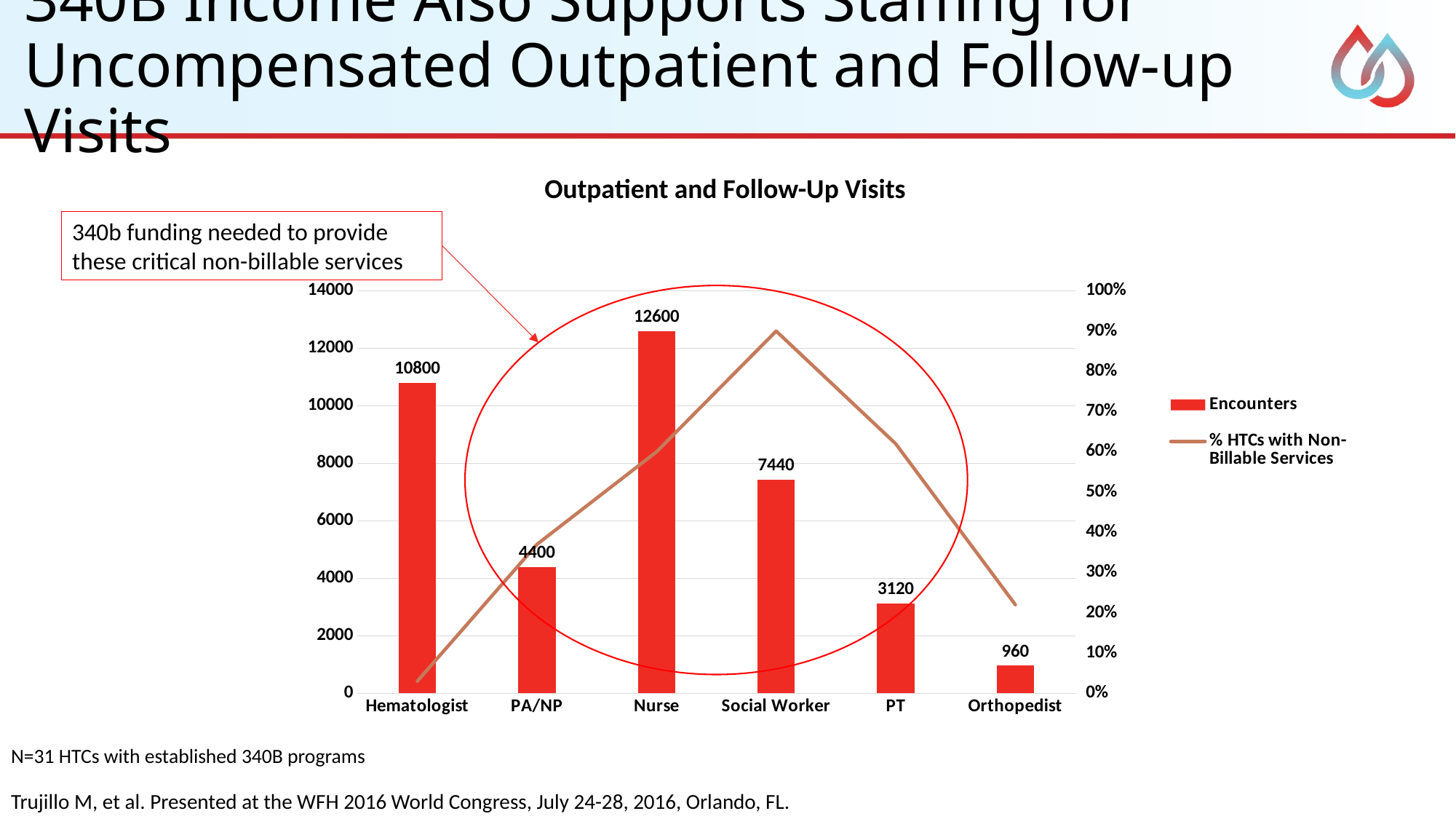
What is the number of Encounters for Social Worker? 7440 Which has more Encounters, Social Worker or PT? Social Worker Which category has the highest number of Encounters? Nurse Is the % HTCs with Non-Billable Services for Hematologist greater or less than 10%? less Which category has the lowest number of Encounters? Orthopedist Is the % HTCs with Non-Billable Services for Social Worker greater or less than 80%? greater How many series does the legend list? 2 What is the number of Encounters for Orthopedist? 960 What is the title of the chart? Outpatient and Follow-Up Visits What is the number of Encounters for Nurse? 12600 What is the difference in Encounters between Hematologist and PA/NP? 6400 How many staff categories are shown on the x axis? 6